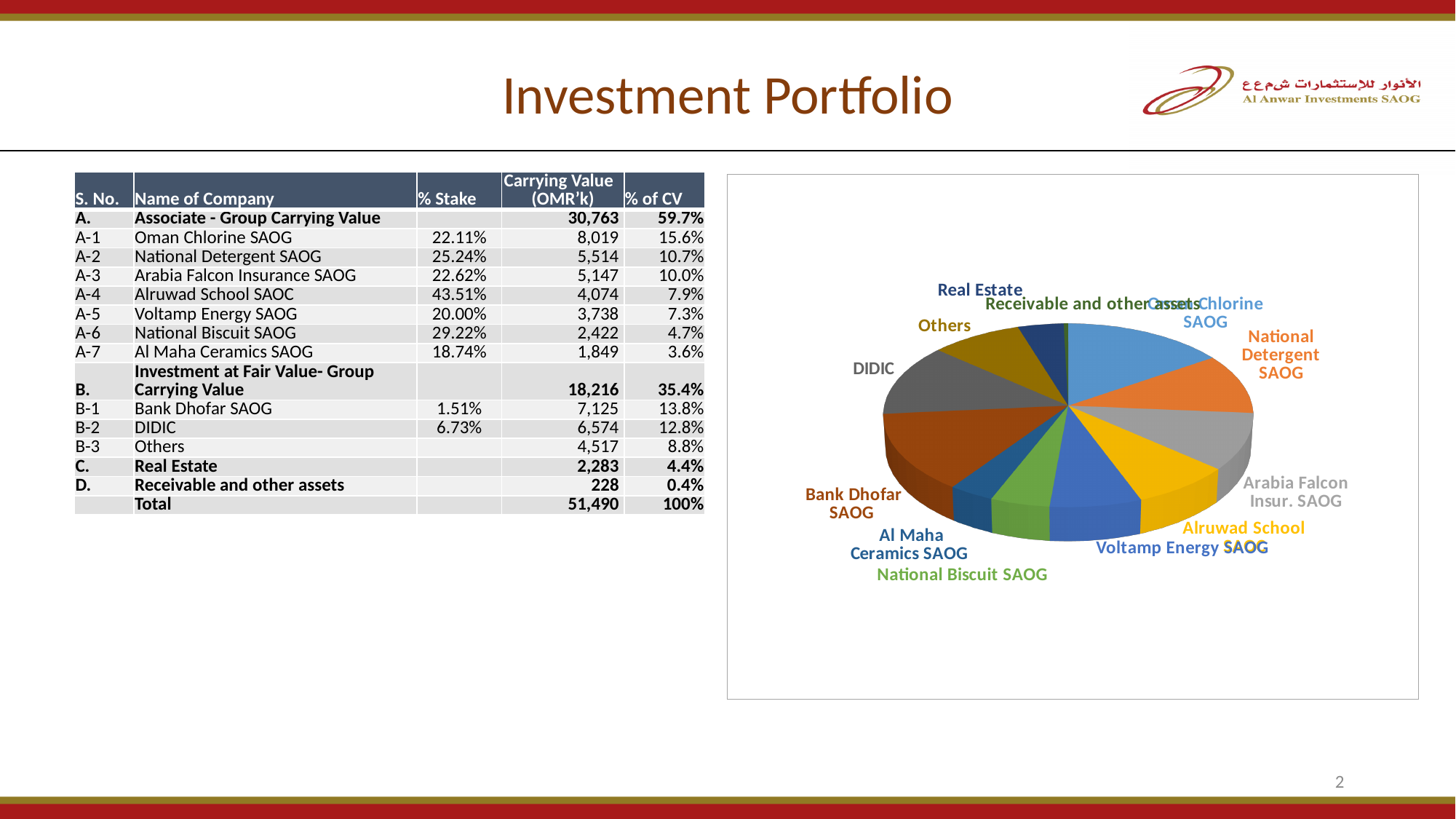
What kind of chart is shown on the slide? pie chart In the pie chart, which slice is larger: Oman Chlorine SAOG or Al Maha Ceramics SAOG? Oman Chlorine SAOG What colour is the Oman Chlorine SAOG slice in the pie chart? light blue According to the table on the slide, what share of the carrying value does the Oman Chlorine SAOG slice represent? 15.6% According to the table on the slide, what is the carrying value (OMR'k) of DIDIC? 6,574 According to the table on the slide, what share of the carrying value does the Bank Dhofar SAOG slice represent? 13.8% In the pie chart, which slice is larger: National Detergent SAOG or Real Estate? National Detergent SAOG Which slice of the pie chart is the smallest? Receivable and other assets What is the title of the slide containing the pie chart? Investment Portfolio In the pie chart, which slice is larger: Bank Dhofar SAOG or National Biscuit SAOG? Bank Dhofar SAOG How many slices does the pie chart have? 12